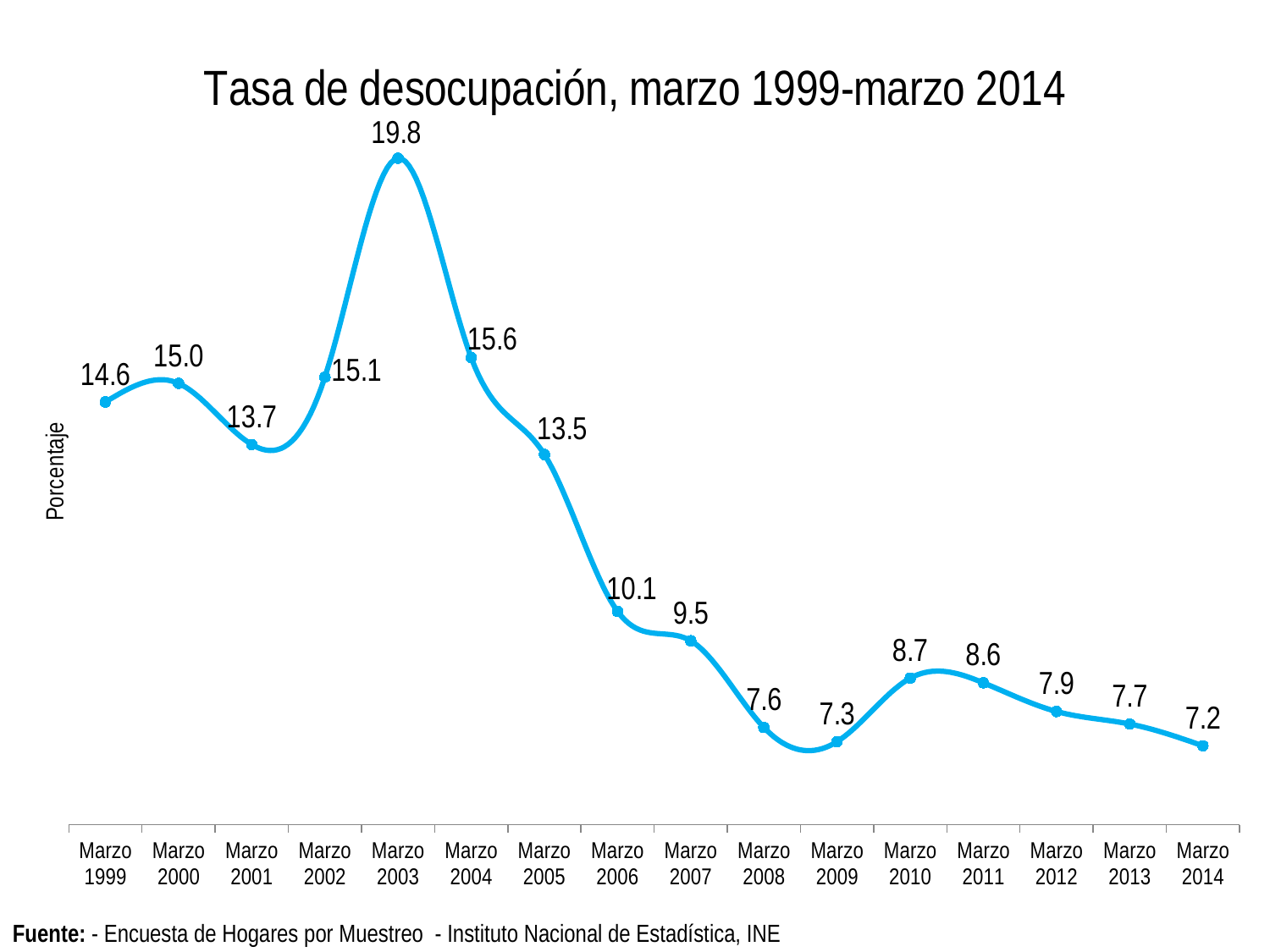
How many data points are plotted on the chart? 16 What is the value for Marzo 2009? 7.3 Do the values rise or fall from Marzo 2004 to Marzo 2009? fall What is the title of the chart? Tasa de desocupación, marzo 1999-marzo 2014 Which point has the highest value? Marzo 2003 What is the value for Marzo 2014? 7.2 Which is larger, the value for Marzo 2010 or Marzo 2011? Marzo 2010 What kind of chart is this? line chart What is the label on the vertical axis? Porcentaje What is the difference between the values for Marzo 2003 and Marzo 2004? 4.2 Which point has the lowest value? Marzo 2014 What is the unemployment rate for Marzo 2003? 19.8